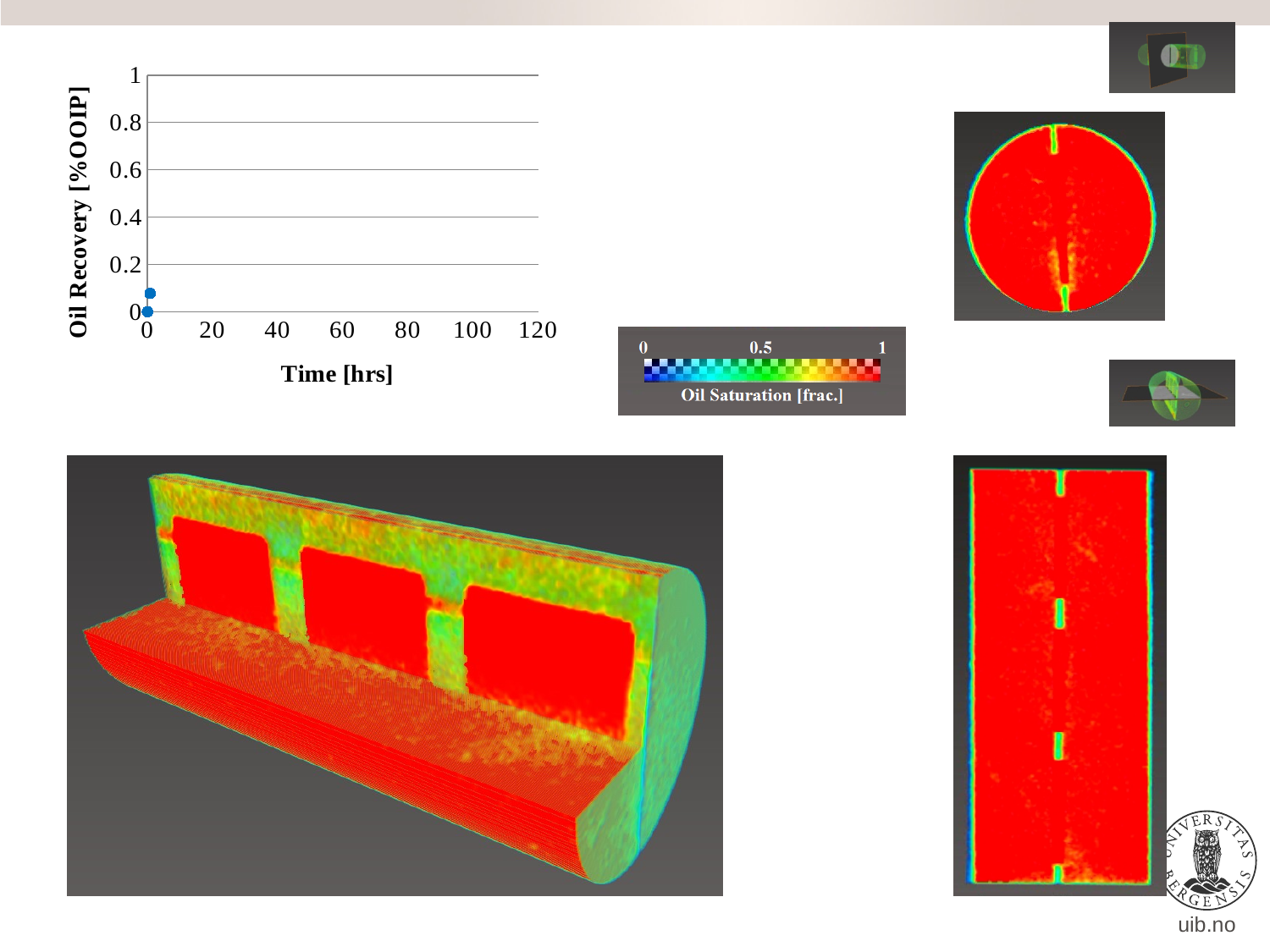
What is the title of the y axis of the chart? Oil Recovery [%OOIP] What kind of chart is shown on the slide? scatter chart What is the maximum value shown on the y axis of the chart? 1 What is the maximum value shown on the x axis of the chart? 120 What is the title of the x axis of the chart? Time [hrs] How many data points are plotted on the chart? 2 Is the oil recovery value of the highest plotted point greater or less than 0.2? less Are the plotted points located at a time greater or less than 20 hrs? less